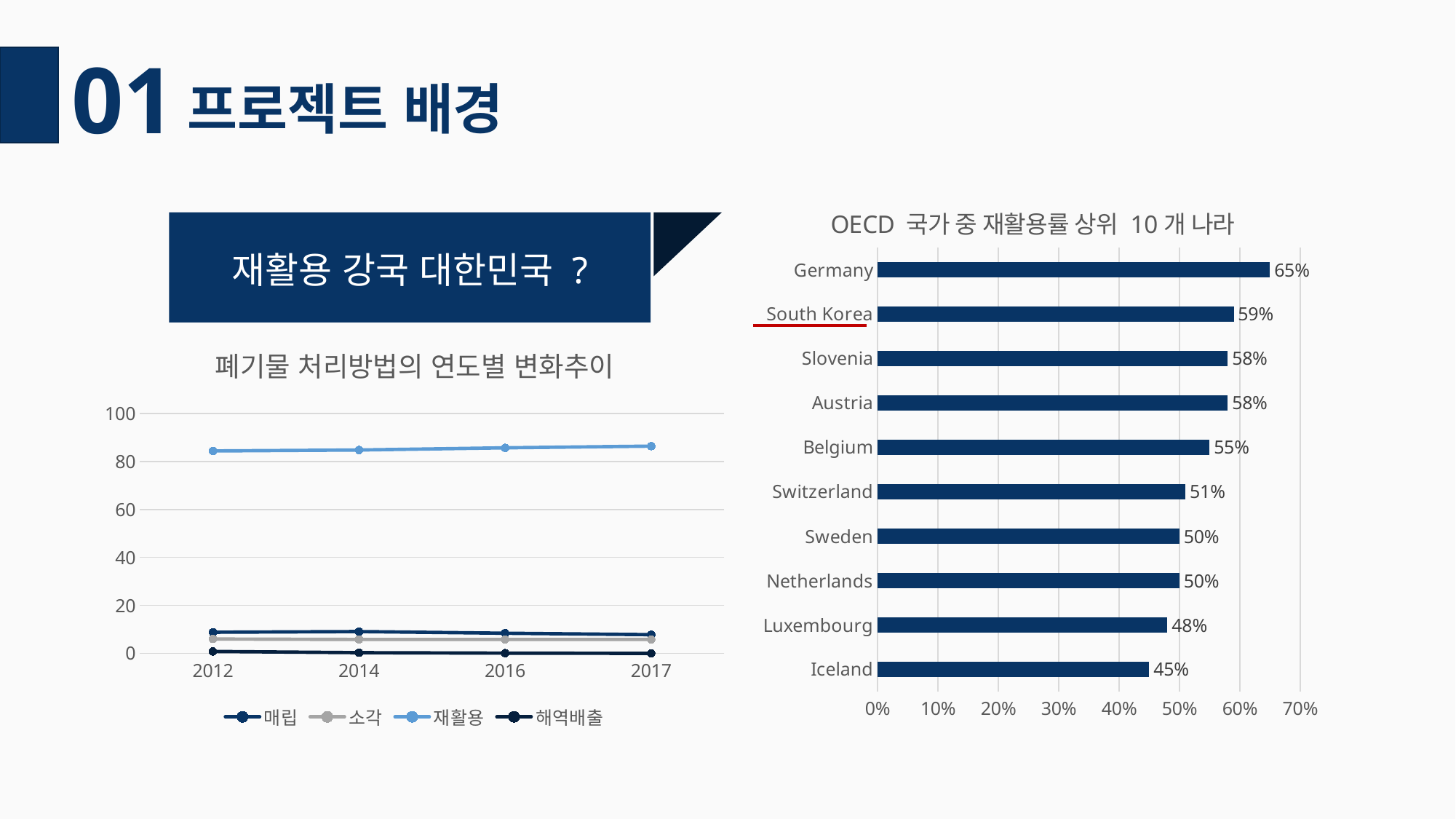
In the chart titled '폐기물 처리방법의 연도별 변화추이', is the value for 재활용 in 2017 greater or less than 80? greater In the chart titled 'OECD 국가 중 재활용률 상위 10개 나라', what is the difference between Germany and South Korea? 6% In the chart titled 'OECD 국가 중 재활용률 상위 10개 나라', how many countries are shown? 10 In the chart titled 'OECD 국가 중 재활용률 상위 10개 나라', which country has the highest value? Germany In the chart titled 'OECD 국가 중 재활용률 상위 10개 나라', what is the value for Belgium? 55% What kind of chart is the chart titled 'OECD 국가 중 재활용률 상위 10개 나라'? Bar chart In the chart titled 'OECD 국가 중 재활용률 상위 10개 나라', what is the value for South Korea? 59% In the chart titled 'OECD 국가 중 재활용률 상위 10개 나라', which country has the lowest value? Iceland In the chart titled 'OECD 국가 중 재활용률 상위 10개 나라', which is larger, the value for Switzerland or the value for Luxembourg? Switzerland In the chart titled '폐기물 처리방법의 연도별 변화추이', how many series does the legend list? 4 In the chart titled '폐기물 처리방법의 연도별 변화추이', how many years are shown on the x axis? 4 What kind of chart is the chart titled '폐기물 처리방법의 연도별 변화추이'? Line chart